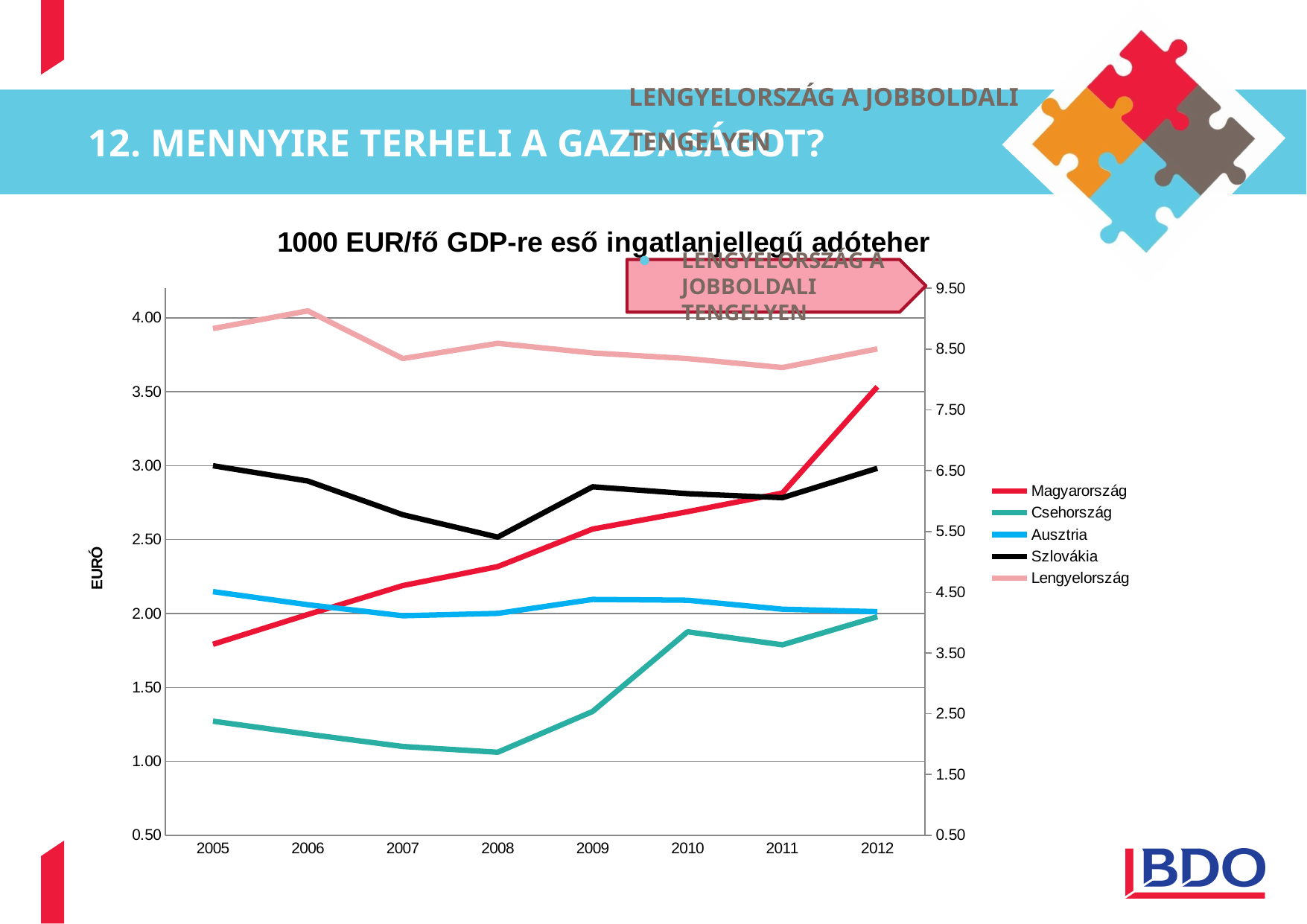
In which year does the Magyarország line reach its highest value? 2012 What is the label on the left vertical axis? EURÓ How many series does the legend list? 5 What kind of chart is shown on the slide? line chart Does the Magyarország line rise or fall from 2005 to 2012? rise Does the Csehország line rise or fall from 2005 to 2008? fall In 2009, which is larger: Szlovákia or Ausztria? Szlovákia Is the value for Csehország in 2008 greater or less than 1.50? less What is the title of the chart? 1000 EUR/fő GDP-re eső ingatlanjellegű adóteher Is the value for Szlovákia in 2005 greater or less than 2.50? greater How many years are shown on the x axis? 8 Is the value for Magyarország in 2012 greater or less than 3.00? greater